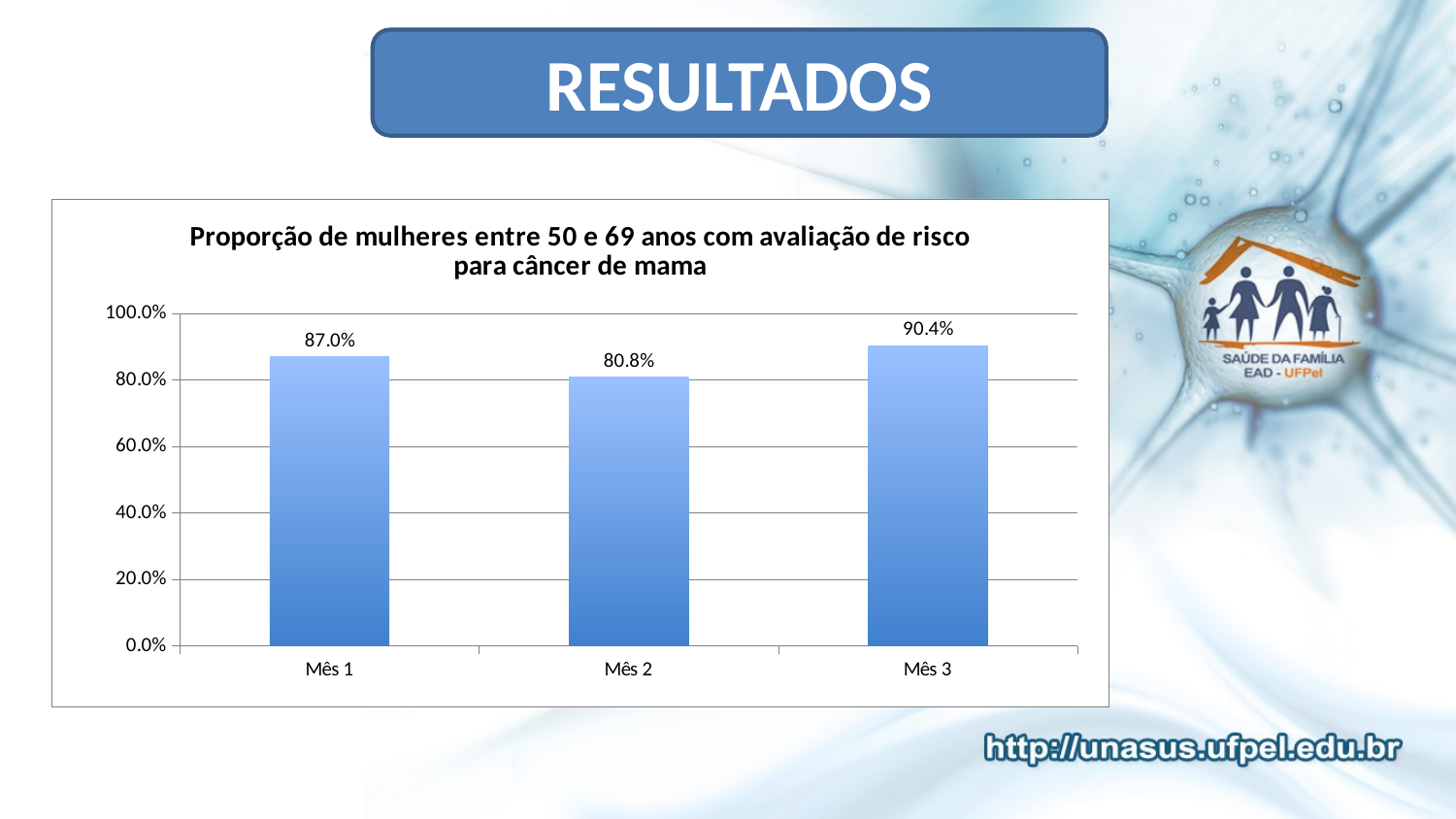
What is the difference between the values for Mês 3 and Mês 2? 9.6% How many months are shown on the x axis? 3 Which month has the highest value? Mês 3 Which month has the lowest value? Mês 2 Is the value for Mês 2 greater or less than 80.0%? greater What is the title of the chart? Proporção de mulheres entre 50 e 69 anos com avaliação de risco para câncer de mama What is the value for Mês 1? 87.0% Which is larger, the value for Mês 1 or the value for Mês 3? Mês 3 What is the difference between the values for Mês 1 and Mês 2? 6.2% What kind of chart is shown on the slide? bar chart What is the value for Mês 3? 90.4% What is the value for Mês 2? 80.8%